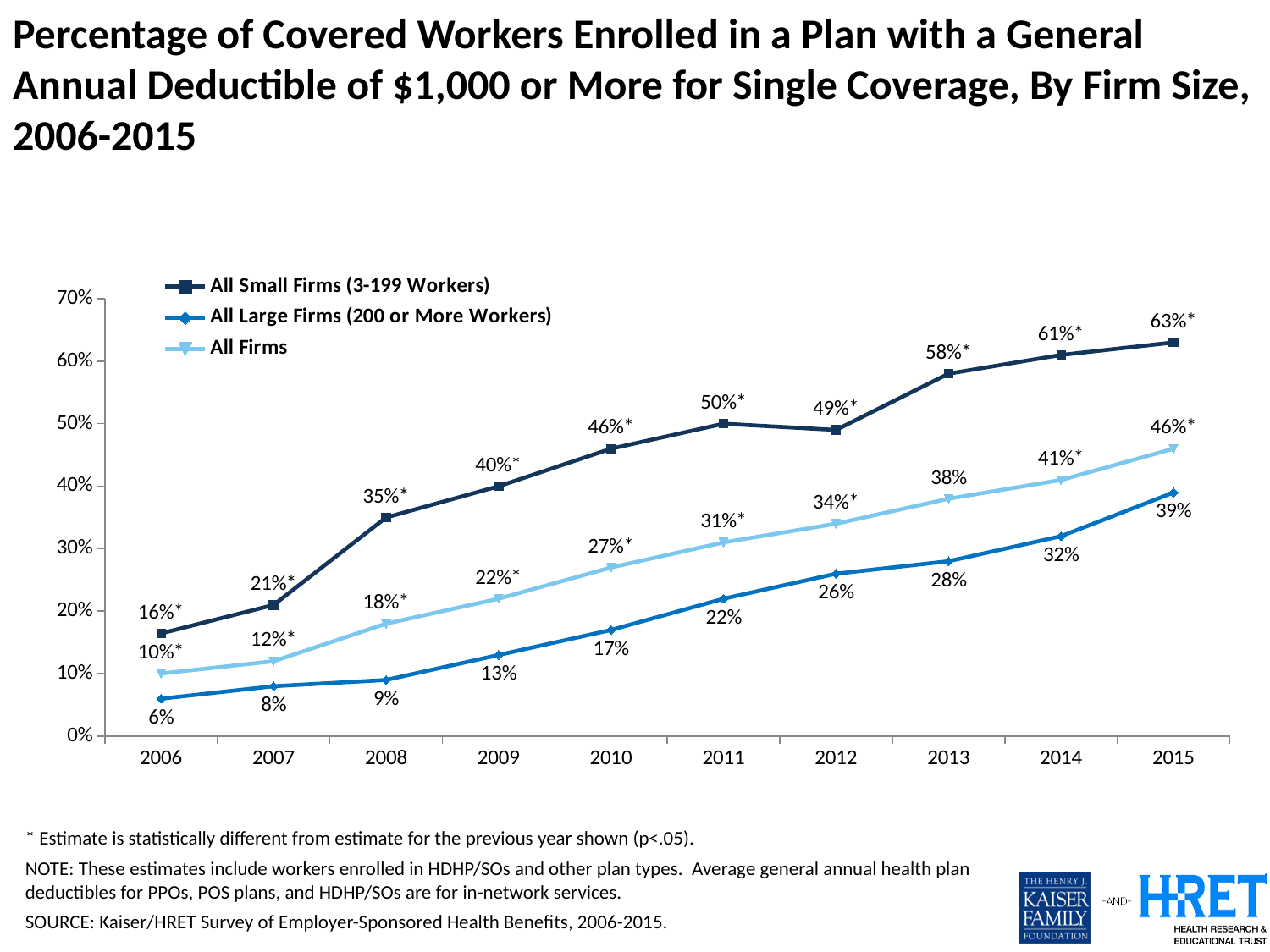
What is the value for All Large Firms (200 or More Workers) in 2006? 6% Does the value for All Large Firms (200 or More Workers) generally rise or fall from 2006 to 2015? rise What is the value for All Small Firms (3-199 Workers) in 2008? 35% In which year is the value for All Large Firms (200 or More Workers) lowest? 2006 Which series has the larger value in 2012, All Firms or All Large Firms (200 or More Workers)? All Firms What is the value for All Large Firms (200 or More Workers) in 2015? 39% In which year is the value for All Small Firms (3-199 Workers) highest? 2015 How many years are plotted along the x axis? 10 What is the difference between the All Small Firms and All Large Firms values in 2015? 24 percentage points What type of chart is shown on the slide? line chart What is the value for All Firms in 2013? 38% How many series does the legend list? 3